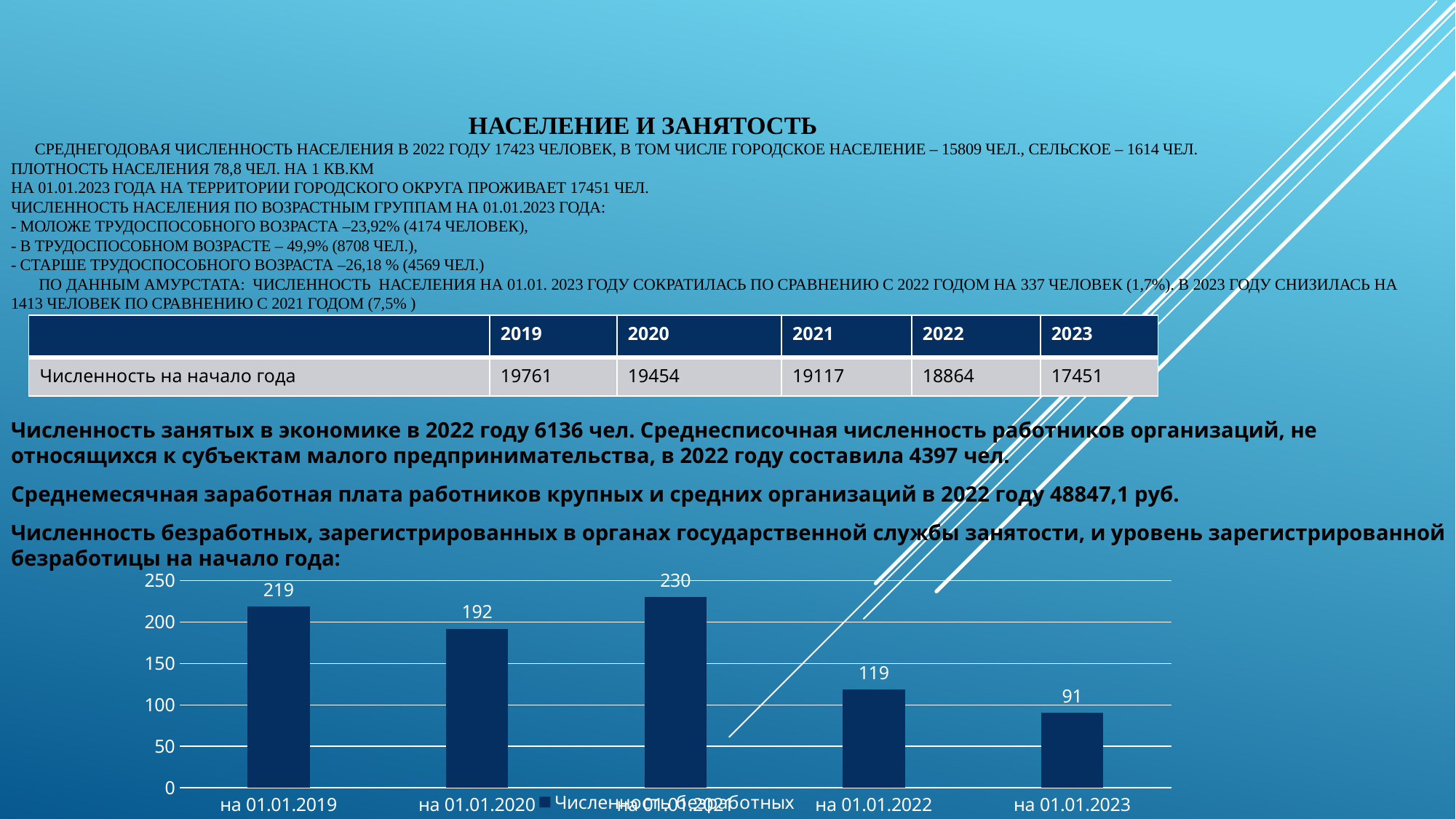
How many series does the chart legend list? 1 Which is larger, the value for на 01.01.2020 or the value for на 01.01.2022? на 01.01.2020 What is the value shown for на 01.01.2022? 119 What is the difference between the values for на 01.01.2019 and на 01.01.2020? 27 What is the difference between the values for на 01.01.2021 and на 01.01.2022? 111 Which date has the highest number of unemployed in the chart? на 01.01.2021 How many bars (dates) are shown in the chart? 5 What type of chart is shown on the slide? bar chart What is the number of registered unemployed on 01.01.2019 (на 01.01.2019)? 219 Which date has the lowest number of unemployed in the chart? на 01.01.2023 What is the value shown for на 01.01.2023? 91 What is the name of the series shown in the chart legend? Численность безработных